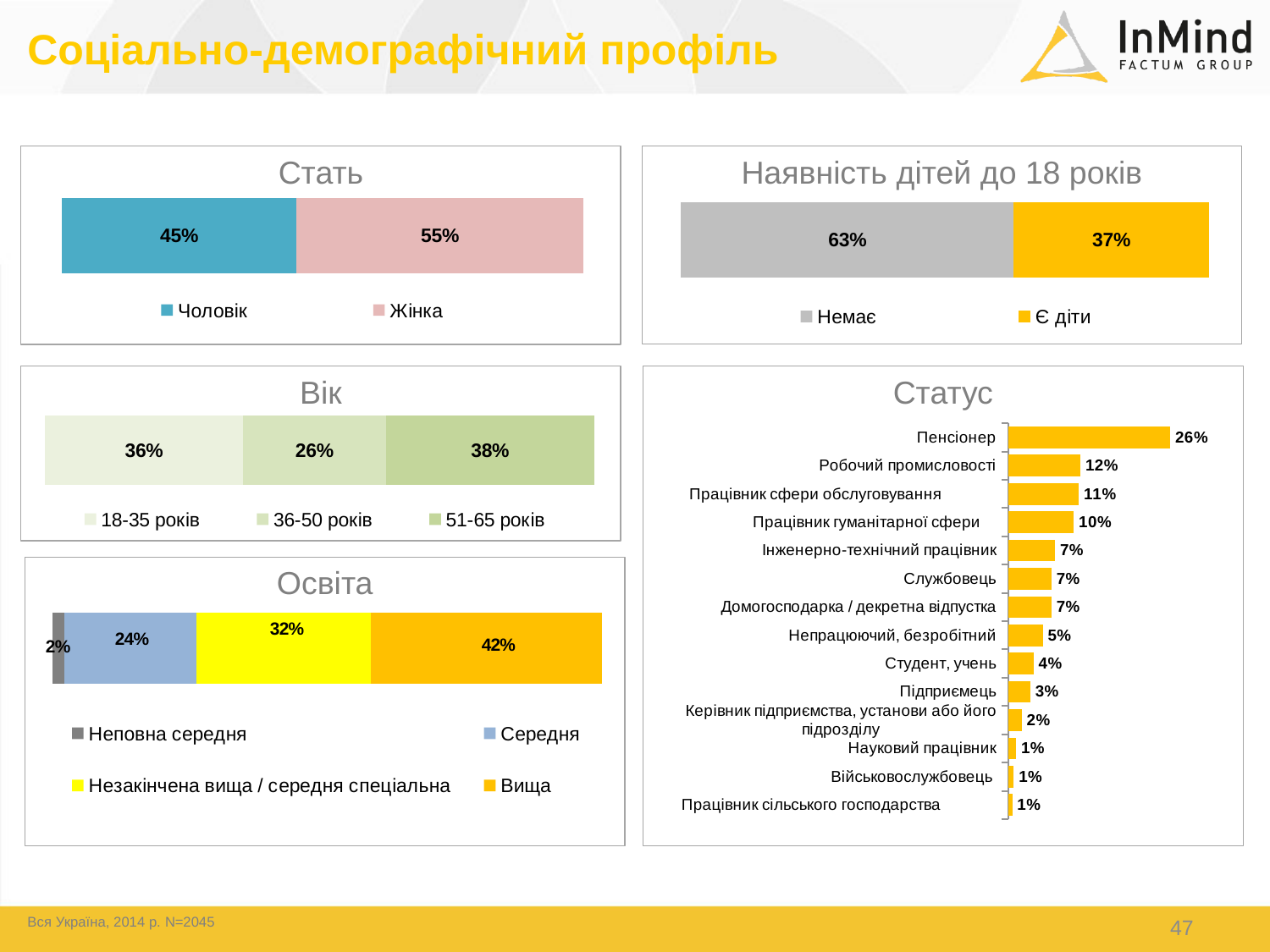
In the "Вік" chart, what is the value for 36-50 років? 26% In the "Стать" chart, what is the value for Жінка? 55% In the "Наявність дітей до 18 років" chart, which is larger, Немає or Є діти? Немає In the "Статус" chart, which category has the highest value? Пенсіонер In the "Освіта" chart, how many series does the legend list? 4 What kind of chart is the "Статус" chart? Bar chart In the "Статус" chart, how many categories are shown? 14 In the "Стать" chart, what is the difference between the values for Жінка and Чоловік? 10% In the "Статус" chart, what is the value for Студент, учень? 4% In the "Вік" chart, which age group has the highest value? 51-65 років In the "Освіта" chart, what is the value for Вища? 42% In the "Наявність дітей до 18 років" chart, what is the value for Немає? 63%